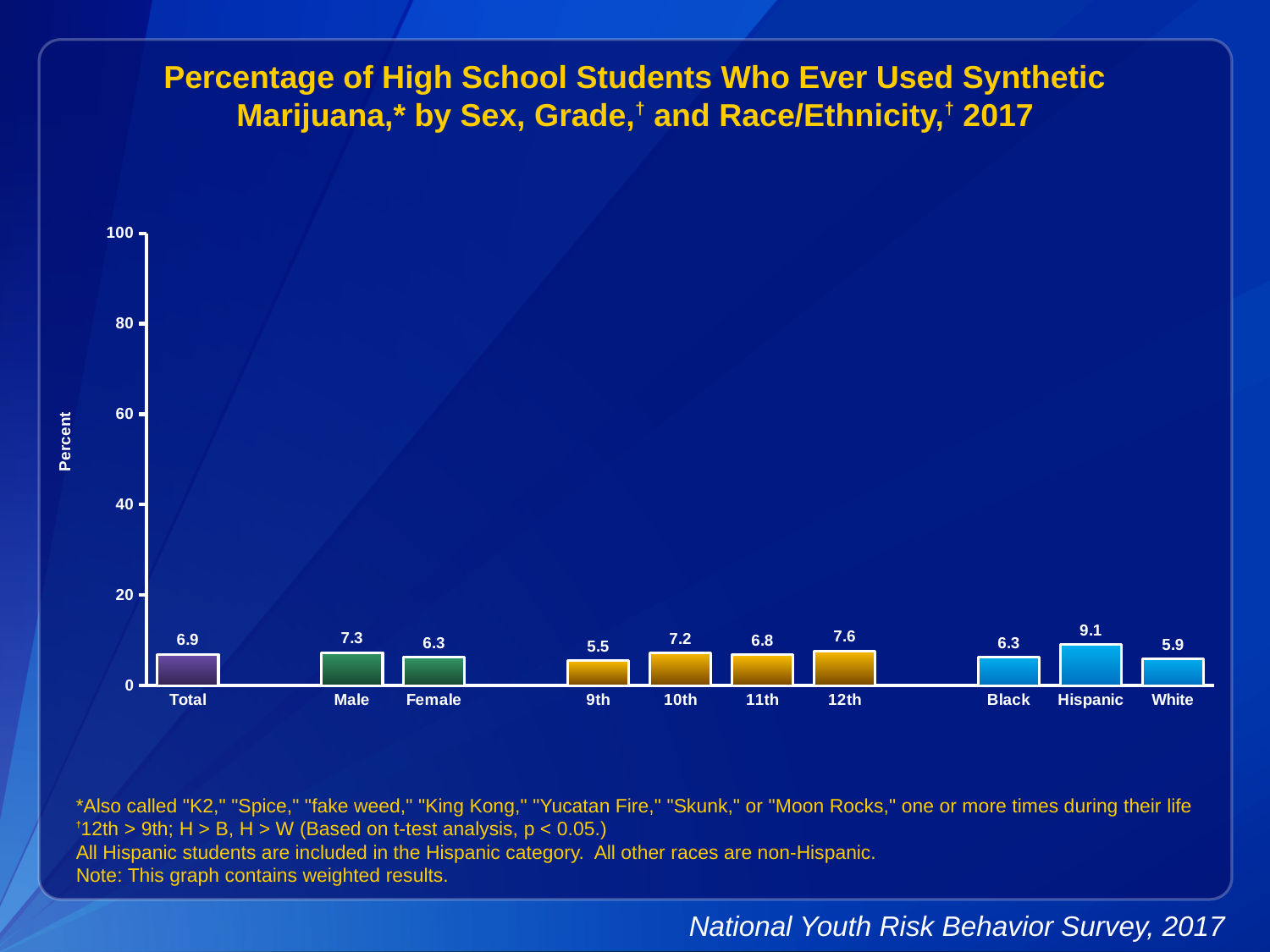
Which category has the lowest value? 9th Do the values rise or fall from 9th grade to 12th grade? rise Is the value for White students greater or less than 20? less How many categories are shown on the x axis? 10 What is the value for Hispanic students? 9.1 What is the difference between the values for Male and Female? 1.0 What is the value for Total? 6.9 Which category has the highest value? Hispanic Which is larger, the value for 12th grade or the value for 10th grade? 12th What kind of chart is this? bar chart What is the label on the y axis? Percent What is the value for 9th grade students? 5.5